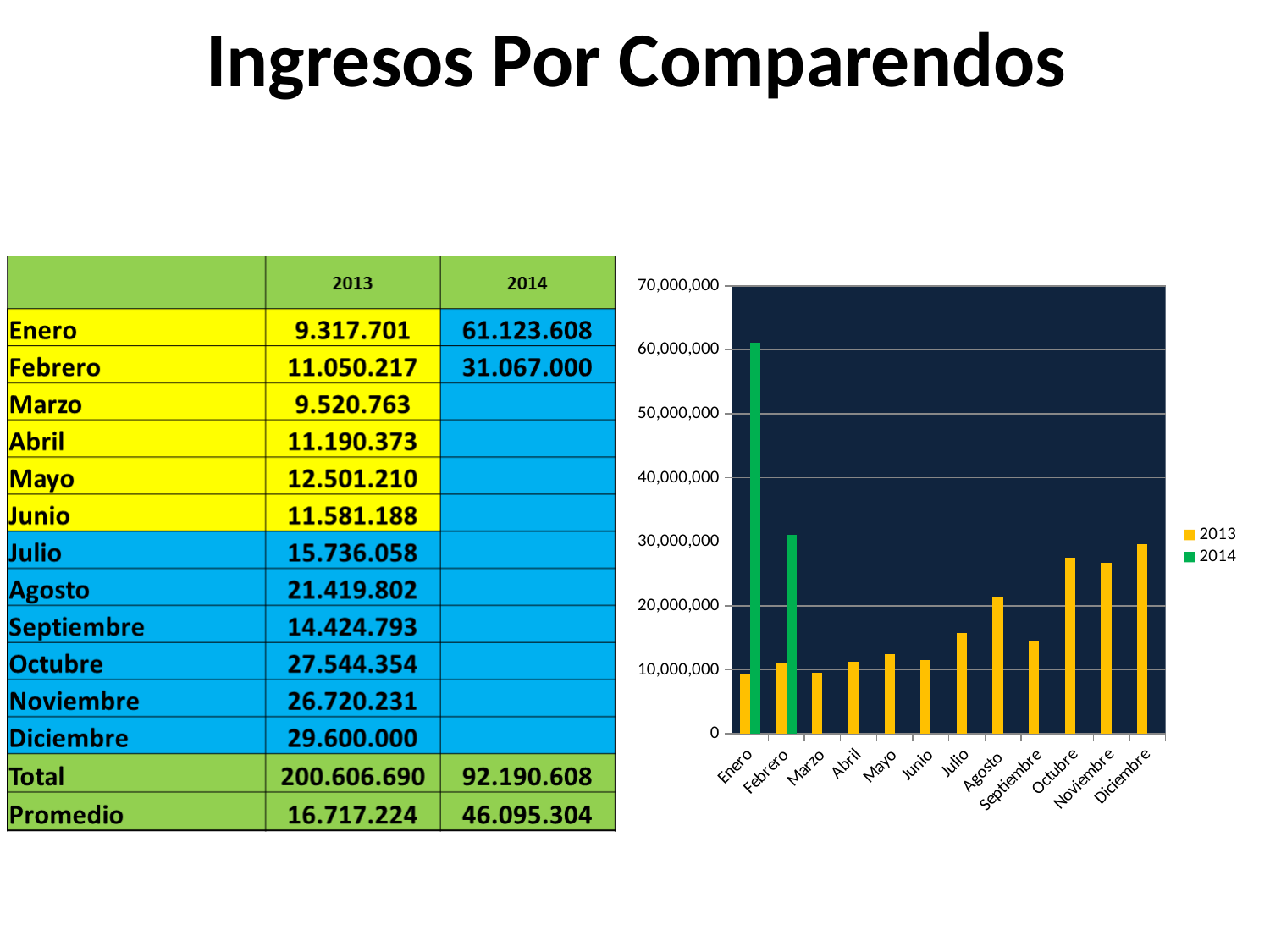
Do the 2013 values generally rise or fall from Enero to Diciembre? rise Which month has the highest 2013 value in the chart? Diciembre What kind of chart is shown on the slide? bar chart How many months are shown along the x axis of the chart? 12 Is the 2014 value for Febrero greater or less than 30,000,000? greater What is the 2014 value for Enero? 61.123.608 Which month has the lowest 2013 value in the chart? Enero How many series does the chart legend list? 2 What is the difference between the 2014 and 2013 values for Enero? 51.805.907 Is the 2013 value for Marzo greater or less than 10,000,000? less Which is larger, the 2014 value for Enero or the 2014 value for Febrero? 2014 value for Enero What is the 2013 value for Octubre? 27.544.354